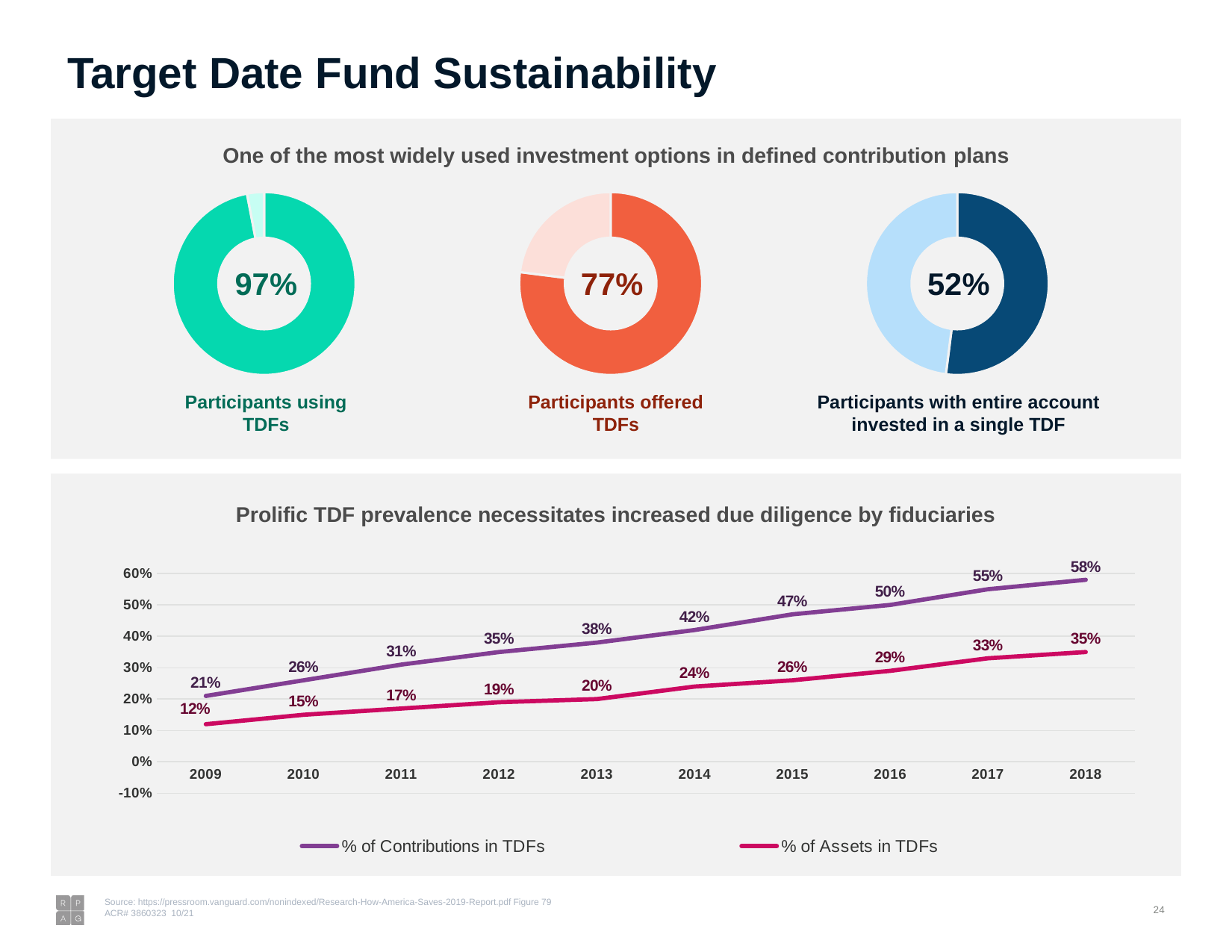
In the line chart, which is larger in 2016: % of Contributions in TDFs or % of Assets in TDFs? % of Contributions in TDFs In the donut chart titled 'Participants with entire account invested in a single TDF', what percentage is shown? 52% What kind of chart is the bottom chart on the slide? Line chart In the line chart, which year has the highest % of Contributions in TDFs? 2018 In the line chart, what is the difference between % of Contributions in TDFs and % of Assets in TDFs in 2018? 23% In the line chart, what is the % of Assets in TDFs for 2011? 17% In the line chart, does the % of Assets in TDFs rise or fall from 2009 to 2018? Rise In the line chart, what is the % of Contributions in TDFs for 2014? 42% In the donut chart titled 'Participants offered TDFs', what percentage is shown? 77% In the line chart, which year has the lowest % of Assets in TDFs? 2009 How many series does the legend of the line chart list? 2 How many years are shown on the x axis of the line chart? 10